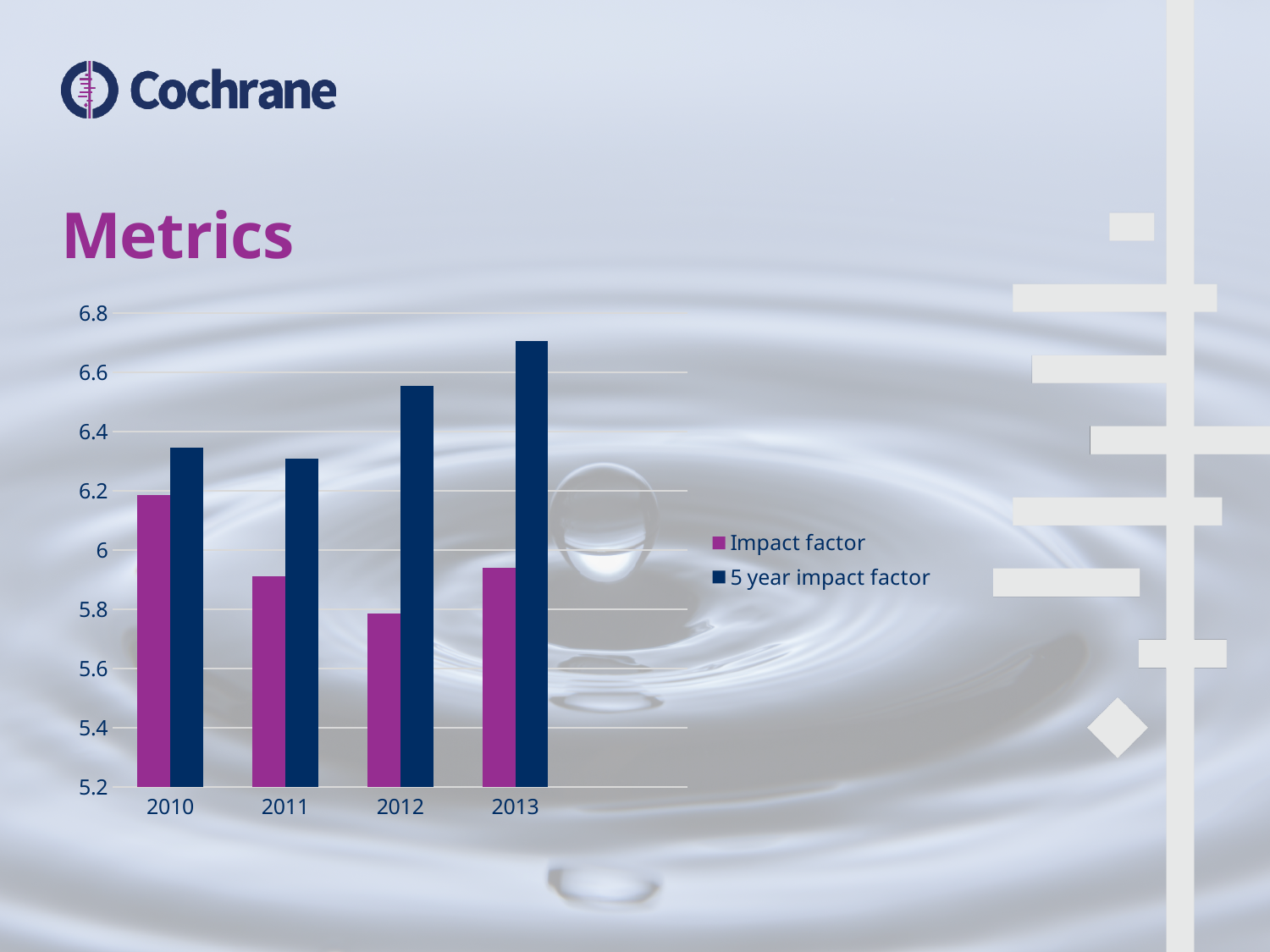
Which year has the highest Impact factor? 2010 How many series does the legend list? 2 Is the 5 year impact factor for 2012 greater or less than 6.4? greater What is the title of the slide? Metrics Is the 5 year impact factor for 2013 greater or less than 6.6? greater Does the 5 year impact factor rise or fall from 2011 to 2013? rise Which year has the highest 5 year impact factor? 2013 Is the Impact factor for 2012 greater or less than 6? less Which year has the lowest Impact factor? 2012 How many years are shown on the x axis? 4 Which is larger, the Impact factor for 2010 or the Impact factor for 2013? 2010 What kind of chart is shown on the slide? bar chart